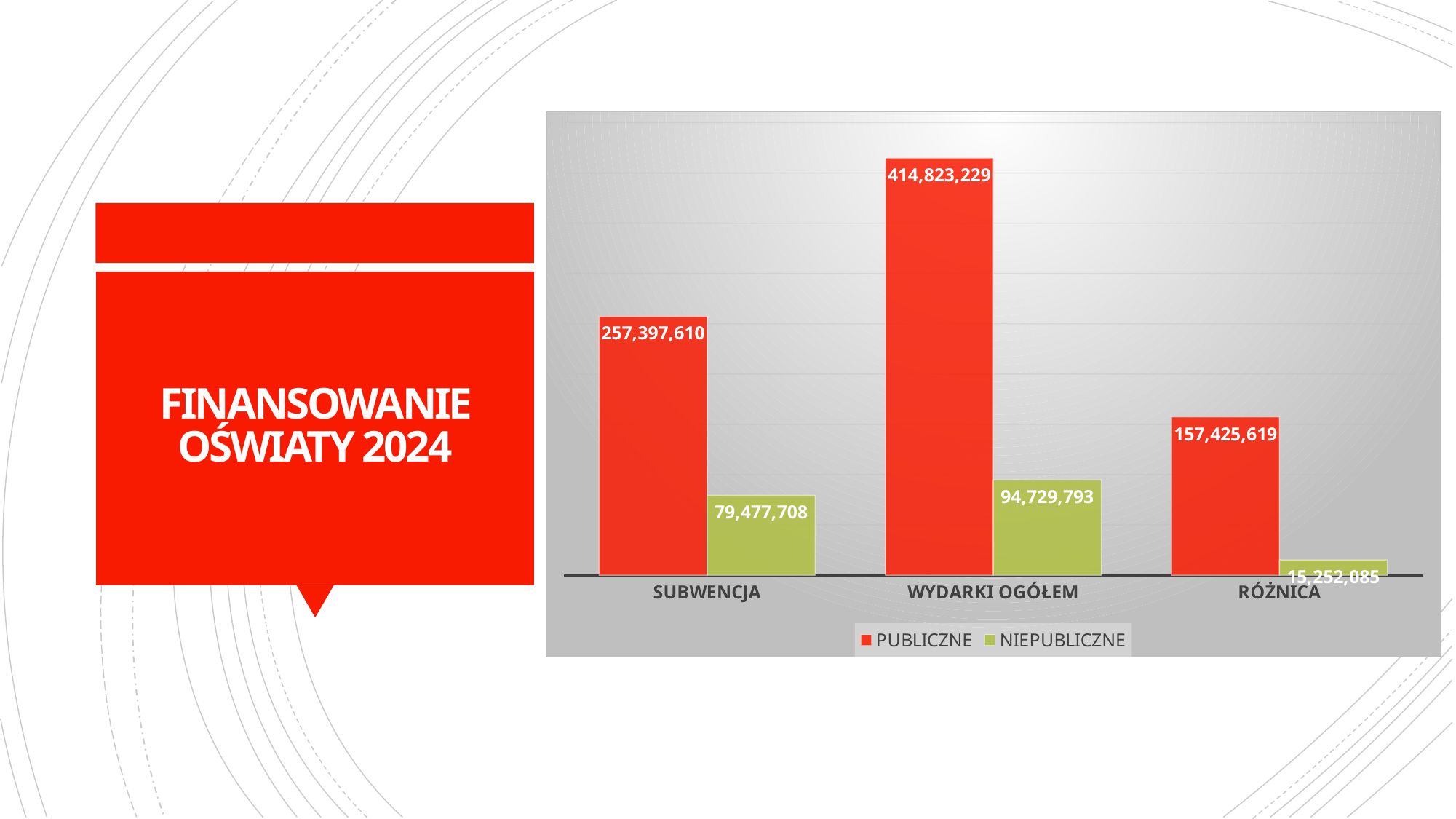
What is the PUBLICZNE value for RÓŻNICA? 157,425,619 What kind of chart is shown on the slide? Bar chart What is the NIEPUBLICZNE value for WYDARKI OGÓŁEM? 94,729,793 How many series does the legend list? 2 What is the difference between the PUBLICZNE and NIEPUBLICZNE values for SUBWENCJA? 177,919,902 What is the PUBLICZNE value for SUBWENCJA? 257,397,610 Which category has the lowest NIEPUBLICZNE value? RÓŻNICA Which is larger: the NIEPUBLICZNE value for SUBWENCJA or the NIEPUBLICZNE value for WYDARKI OGÓŁEM? WYDARKI OGÓŁEM How many categories are shown on the x axis? 3 Which category has the highest PUBLICZNE value? WYDARKI OGÓŁEM What is the NIEPUBLICZNE value for RÓŻNICA? 15,252,085 What is the difference between the PUBLICZNE values for WYDARKI OGÓŁEM and SUBWENCJA? 157,425,619